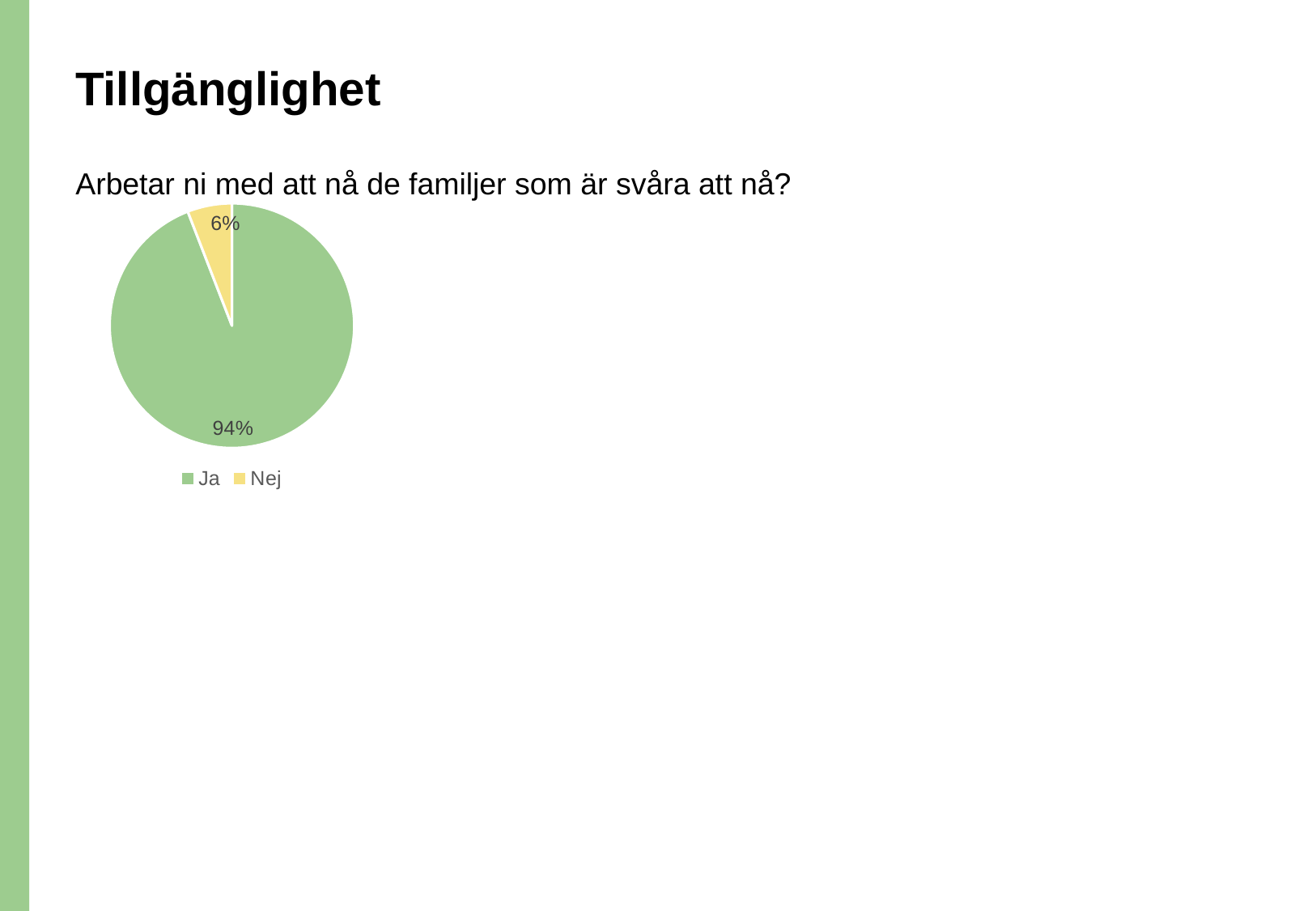
What share of the pie does the "Nej" slice represent? 6% Which category has the smallest share of the pie chart? Nej How many slices does the pie chart have? 2 What question is the pie chart answering, according to the text above it? Arbetar ni med att nå de familjer som är svåra att nå? What colour is the "Ja" slice in the pie chart? Green How many entries does the chart legend list? 2 What percentage of the pie chart is labelled "Nej"? 6% What is the difference in percentage points between the "Ja" and "Nej" slices? 88 Which category has the largest share of the pie chart? Ja What percentage of the pie chart is labelled "Ja"? 94% What kind of chart is shown on the slide? Pie chart Which slice is larger, "Ja" or "Nej"? Ja